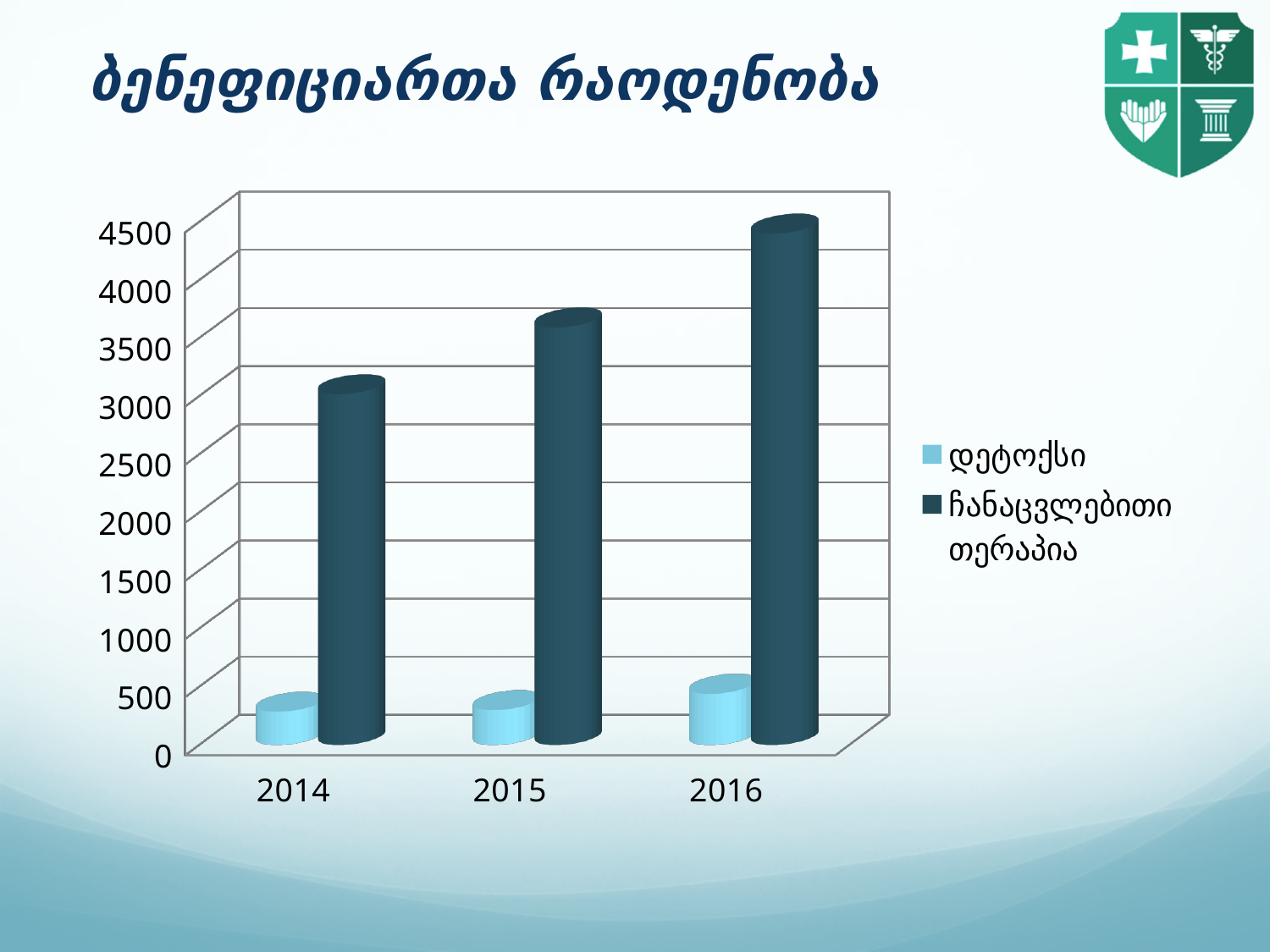
Is the value for დეტოქსი in 2014 greater or less than 500? less Is the value for ჩანაცვლებითი თერაპია in 2015 greater or less than 4000? less Do the values for ჩანაცვლებითი თერაპია rise or fall from 2014 to 2016? rise Is the value for ჩანაცვლებითი თერაპია in 2016 greater or less than 4000? greater In which year is the value for ჩანაცვლებითი თერაპია lowest? 2014 In which year is the value for ჩანაცვლებითი თერაპია highest? 2016 What is the title of the chart slide? ბენეფიციართა რაოდენობა Which is larger: the value for ჩანაცვლებითი თერაპია in 2016 or in 2014? 2016 What kind of chart is shown on the slide? bar chart How many series does the chart legend list? 2 How many years are shown on the x axis of the chart? 3